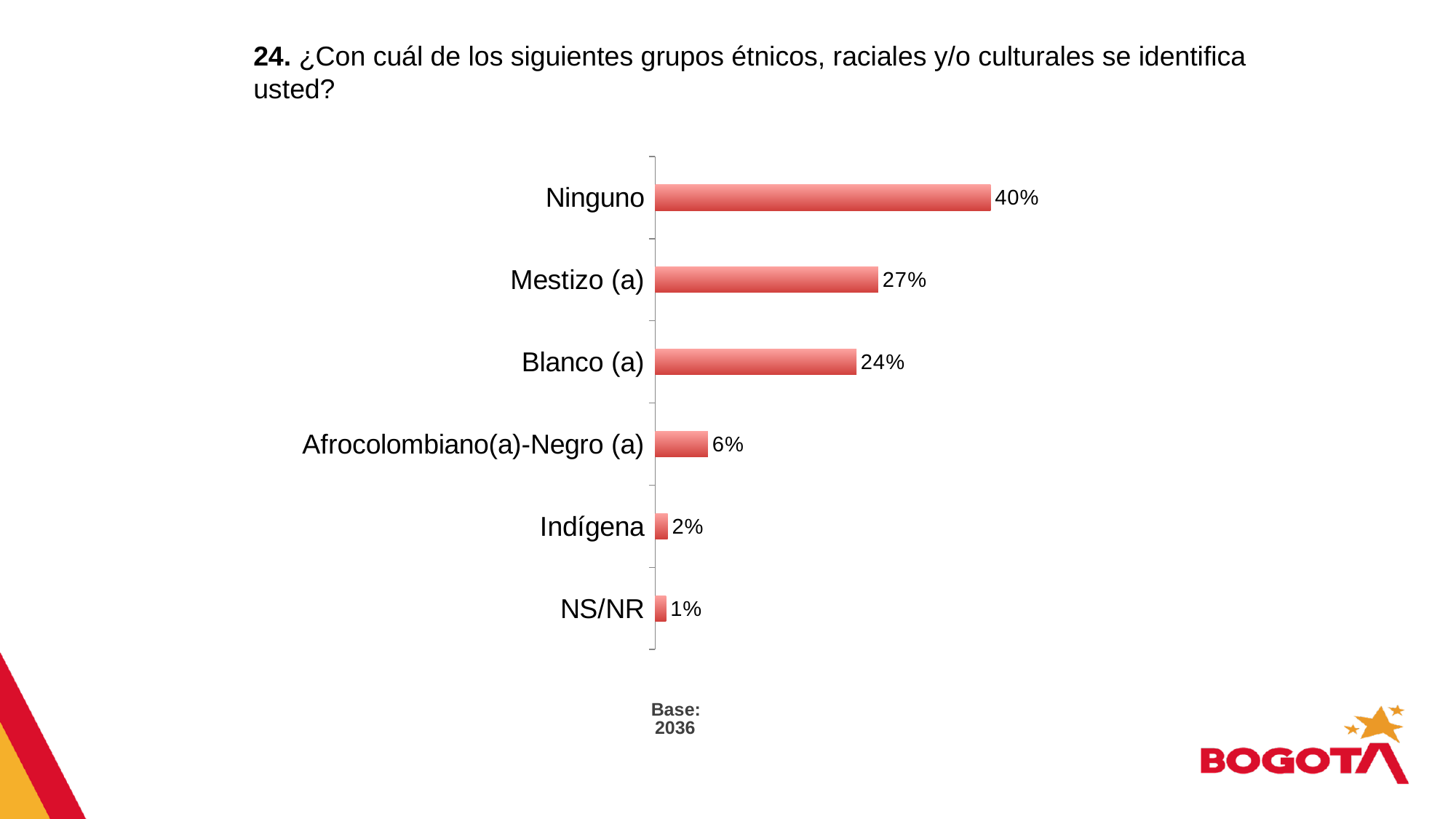
What is the value shown for "Indígena"? 2% What is the difference between the values for "Blanco (a)" and "Afrocolombiano(a)-Negro (a)"? 18% How many categories are shown in the chart? 6 What is the value shown for "Mestizo (a)"? 27% What is the base (number of respondents) shown below the chart? 2036 What percentage of respondents answered "Ninguno"? 40% What is the difference between the values for "Ninguno" and "Mestizo (a)"? 13% Which is larger, the value for "Mestizo (a)" or the value for "Blanco (a)"? Mestizo (a) What kind of chart is shown on the slide? Bar chart Which category has the lowest value? NS/NR Which category has the highest value? Ninguno What is the value shown for "Afrocolombiano(a)-Negro (a)"? 6%